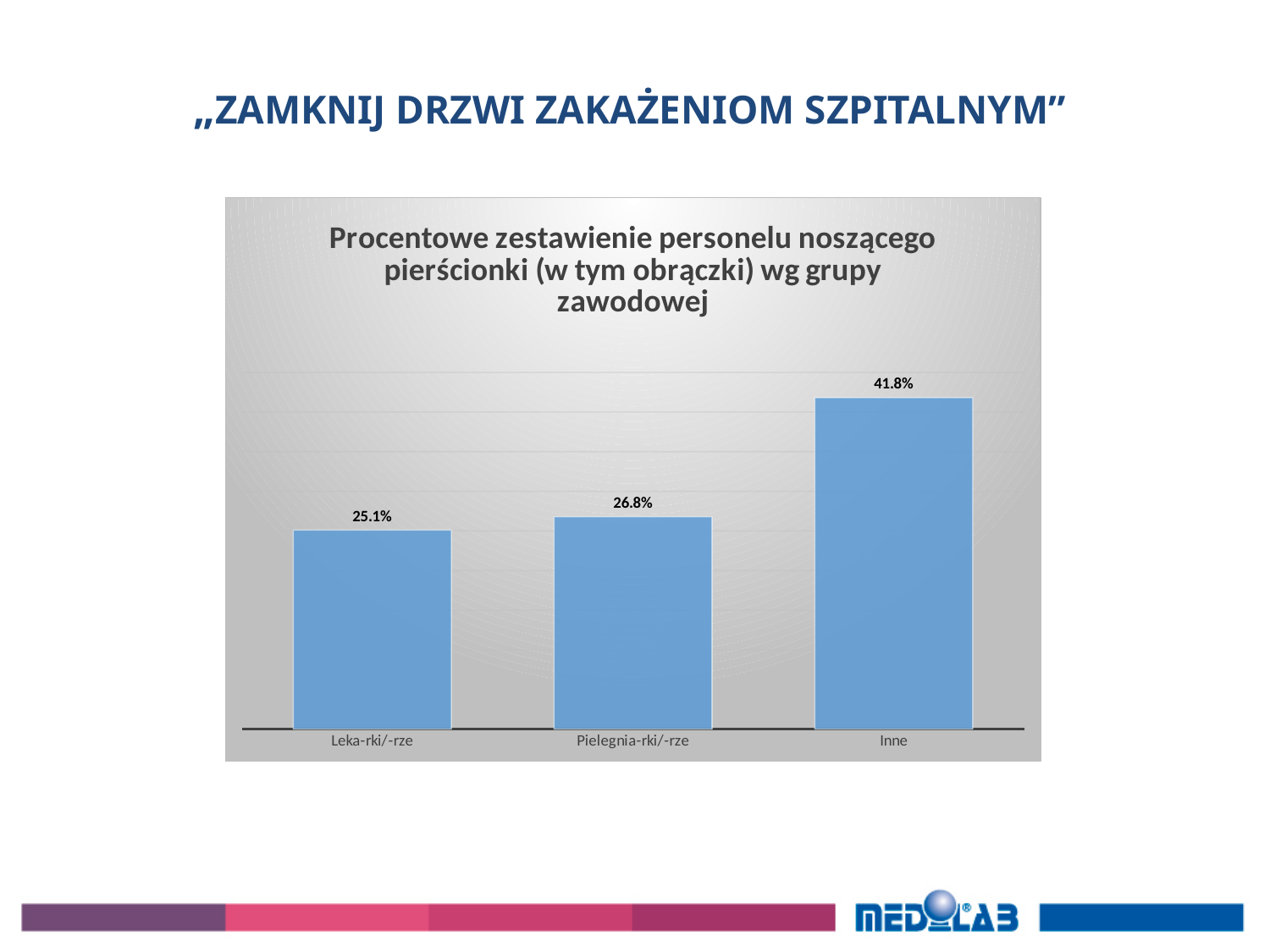
Which category has the highest value? Inne What is the difference between the values for Inne and Leka-rki/-rze? 16.7% What is the title of the chart? Procentowe zestawienie personelu noszącego pierścionki (w tym obrączki) wg grupy zawodowej What is the difference between the values for Pielegnia-rki/-rze and Leka-rki/-rze? 1.7% Which is larger, the value for Inne or the value for Pielegnia-rki/-rze? Inne What is the value for Inne? 41.8% What is the value for Pielegnia-rki/-rze? 26.8% What kind of chart is shown on the slide? Bar chart Which category has the lowest value? Leka-rki/-rze Do the values rise or fall from left to right across the categories? Rise How many categories are shown on the chart? 3 What is the value for Leka-rki/-rze? 25.1%